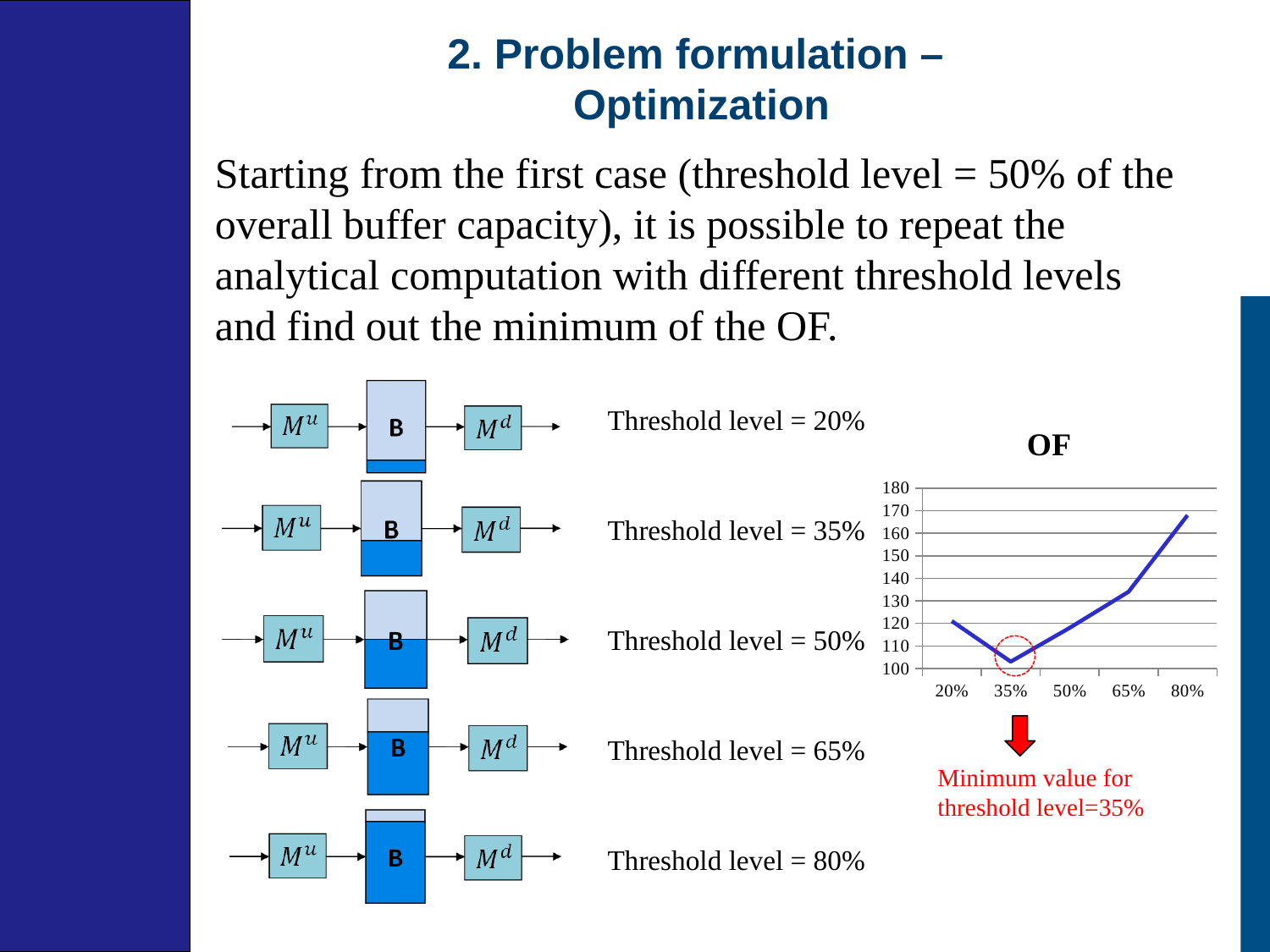
At which threshold level is the OF value lowest? 35% How many threshold levels are plotted on the x axis of the chart? 5 What kind of chart is shown on the slide? line chart Which has the larger OF value, threshold level 65% or threshold level 35%? 65% Is the OF value for threshold level 80% greater or less than 150? greater Is the OF value for threshold level 65% greater or less than 120? greater According to the annotation below the chart, at which threshold level is the minimum value found? 35% Which has the larger OF value, threshold level 80% or threshold level 20%? 80% How does the OF value change as the threshold level increases from 35% to 80%? it rises Is the OF value for threshold level 35% greater or less than 120? less At which threshold level is the OF value highest? 80% What is the title of the chart? OF